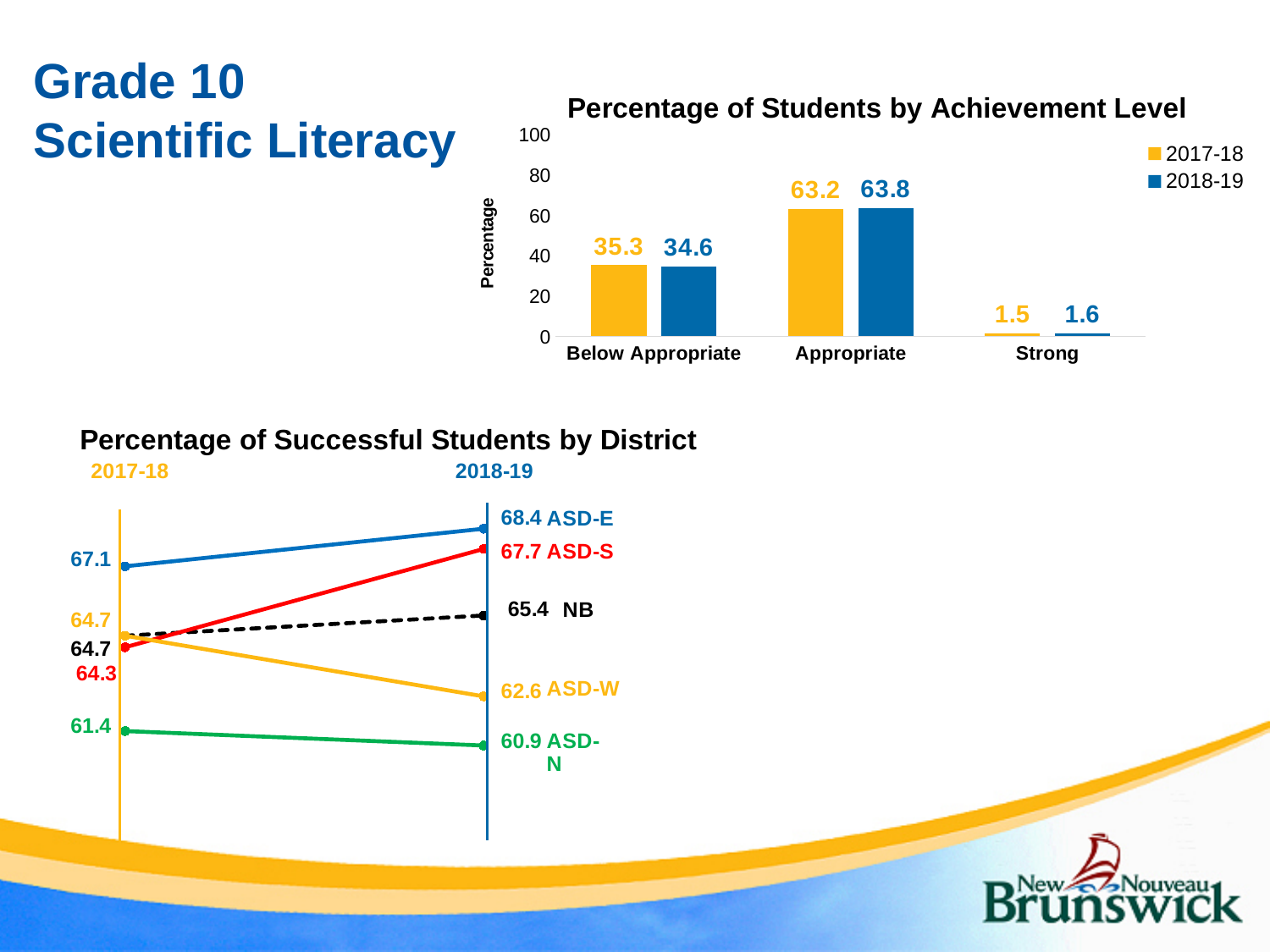
In the 'Percentage of Students by Achievement Level' chart, what is the 2018-19 value for Appropriate? 63.8 In the 'Percentage of Students by Achievement Level' chart, which achievement level has the highest percentage in 2018-19? Appropriate In the 'Percentage of Students by Achievement Level' chart, how many series does the legend list? 2 In the 'Percentage of Students by Achievement Level' chart, what is the 2018-19 value for Strong? 1.6 In the 'Percentage of Successful Students by District' chart, which district has the lowest percentage in 2018-19? ASD-N In the 'Percentage of Students by Achievement Level' chart, which achievement level has the lowest percentage in 2017-18? Strong In the 'Percentage of Successful Students by District' chart, what is the 2018-19 value for ASD-S? 67.7 What kind of chart is 'Percentage of Students by Achievement Level'? Bar chart In the 'Percentage of Students by Achievement Level' chart, what is the difference between the 2017-18 and 2018-19 values for Below Appropriate? 0.7 In the 'Percentage of Successful Students by District' chart, which district has the highest percentage in 2018-19? ASD-E In the 'Percentage of Students by Achievement Level' chart, what is the 2017-18 value for Below Appropriate? 35.3 In the 'Percentage of Successful Students by District' chart, did the NB value rise or fall from 2017-18 to 2018-19? Rise